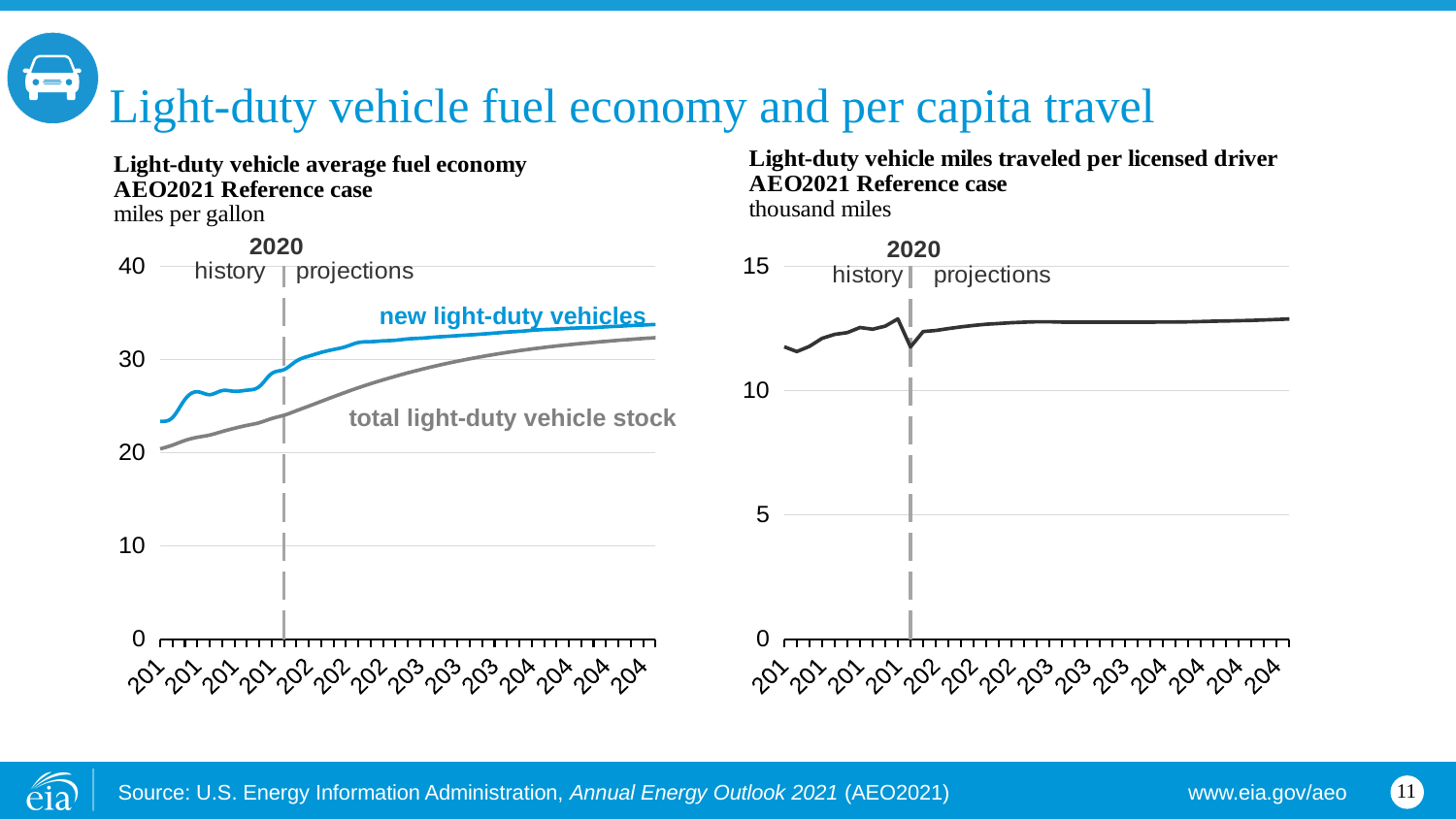
In the left chart, 'Light-duty vehicle average fuel economy', how many series are plotted? 2 In the left chart, 'Light-duty vehicle average fuel economy', is the value for total light-duty vehicle stock at the start of the history period greater or less than 30? less In the right chart, 'Light-duty vehicle miles traveled per licensed driver', is the value at the end of the projection period greater or less than 15? less What kind of chart is the left chart, 'Light-duty vehicle average fuel economy'? line chart In the left chart, 'Light-duty vehicle average fuel economy', does the total light-duty vehicle stock line rise or fall over time? rise In the right chart, 'Light-duty vehicle miles traveled per licensed driver', is the value at the end of the projection period greater or less than 10? greater What unit is shown on the left chart, 'Light-duty vehicle average fuel economy'? miles per gallon In the right chart, 'Light-duty vehicle miles traveled per licensed driver', how many series are plotted? 1 What kind of chart is the right chart, 'Light-duty vehicle miles traveled per licensed driver'? line chart In the left chart, 'Light-duty vehicle average fuel economy', does the new light-duty vehicles line rise or fall over time? rise In the left chart, 'Light-duty vehicle average fuel economy', which series is higher throughout: new light-duty vehicles or total light-duty vehicle stock? new light-duty vehicles